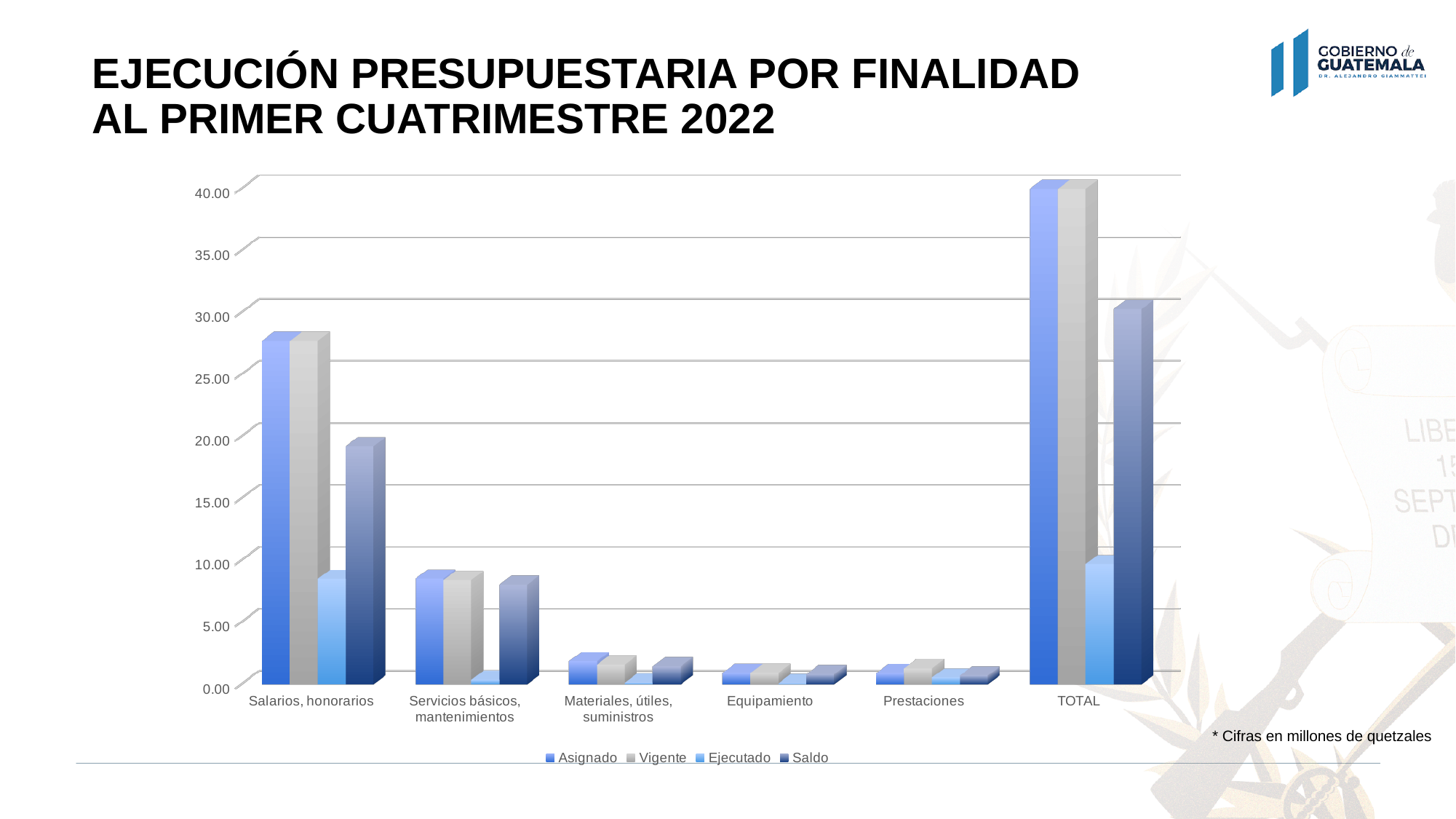
What unit are the figures in, according to the note on the slide? millones de quetzales Is the Asignado value for TOTAL greater or less than 35.00? greater Is the Asignado value for Salarios, honorarios greater or less than 25.00? greater How many categories are shown on the x axis? 6 Which category has the highest Asignado value? TOTAL How many series does the legend list? 4 Is the Ejecutado value for Servicios básicos, mantenimientos greater or less than 5.00? less Which is larger for Salarios, honorarios: the Saldo value or the Ejecutado value? Saldo What type of chart is shown on the slide? bar chart Excluding TOTAL, which category has the highest Asignado value? Salarios, honorarios Which series has the lowest value for Salarios, honorarios? Ejecutado